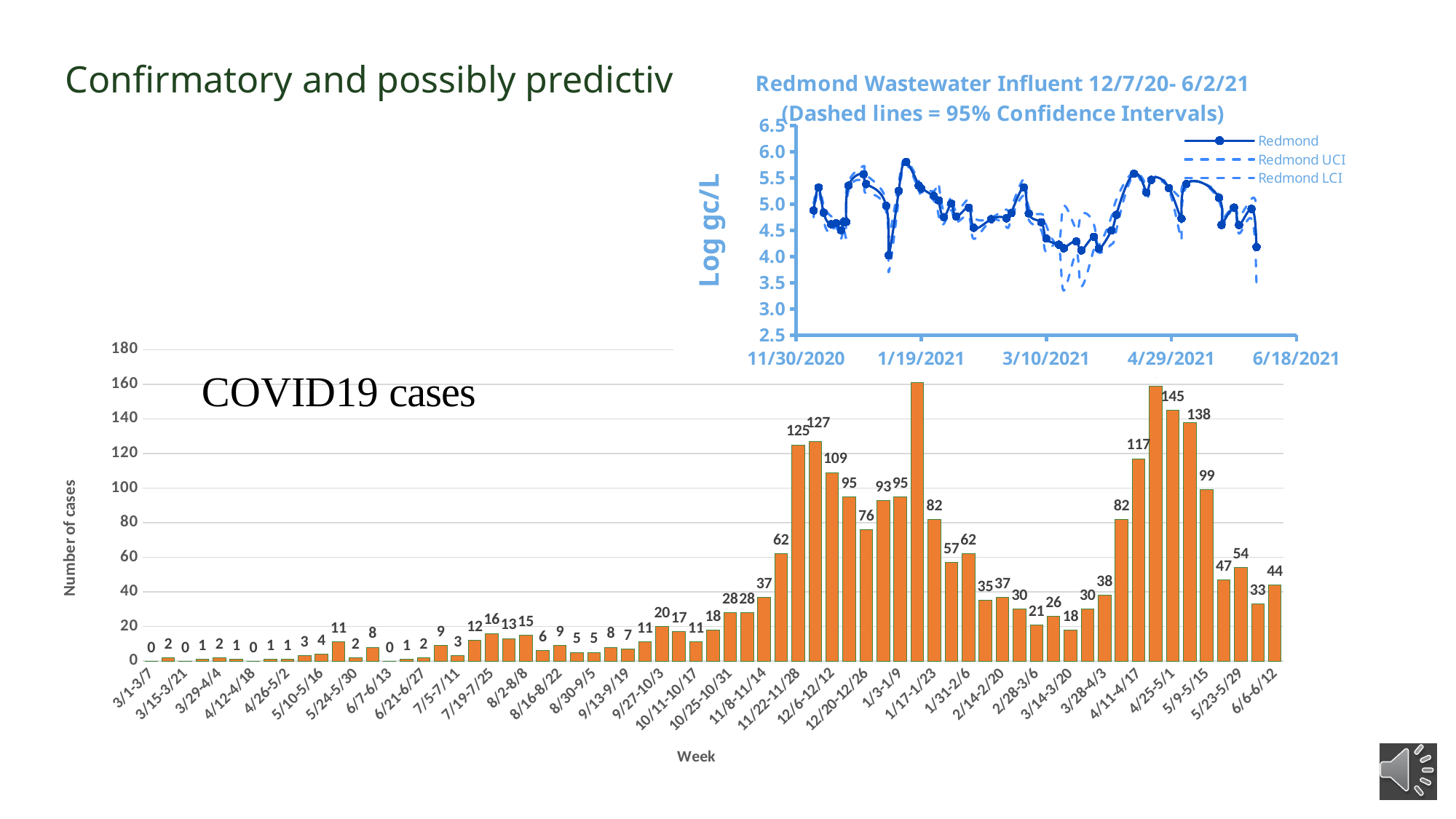
What kind of chart is the Redmond Wastewater Influent chart? line chart In the COVID19 cases chart, how many cases are shown for the week 6/6-6/12? 44 In the COVID19 cases chart, how many cases are shown for the week 5/9-5/15? 99 In the COVID19 cases chart, which week has more cases, 12/6-12/12 or 1/17-1/23? 12/6-12/12 In the COVID19 cases chart, is the value for the week 4/11-4/17 greater or less than 100? greater In the COVID19 cases chart, how many cases are shown for the week 4/25-5/1? 145 What is the y-axis label of the Redmond Wastewater Influent chart? Log gc/L In the Redmond Wastewater Influent chart, what do the dashed lines represent according to the title? 95% Confidence Intervals How many series does the legend of the Redmond Wastewater Influent chart list? 3 In the COVID19 cases chart, how many cases are shown for the week 11/22-11/28? 125 In the COVID19 cases chart, what is the difference in cases between the weeks 4/25-5/1 and 5/9-5/15? 46 What kind of chart is the COVID19 cases chart? bar chart